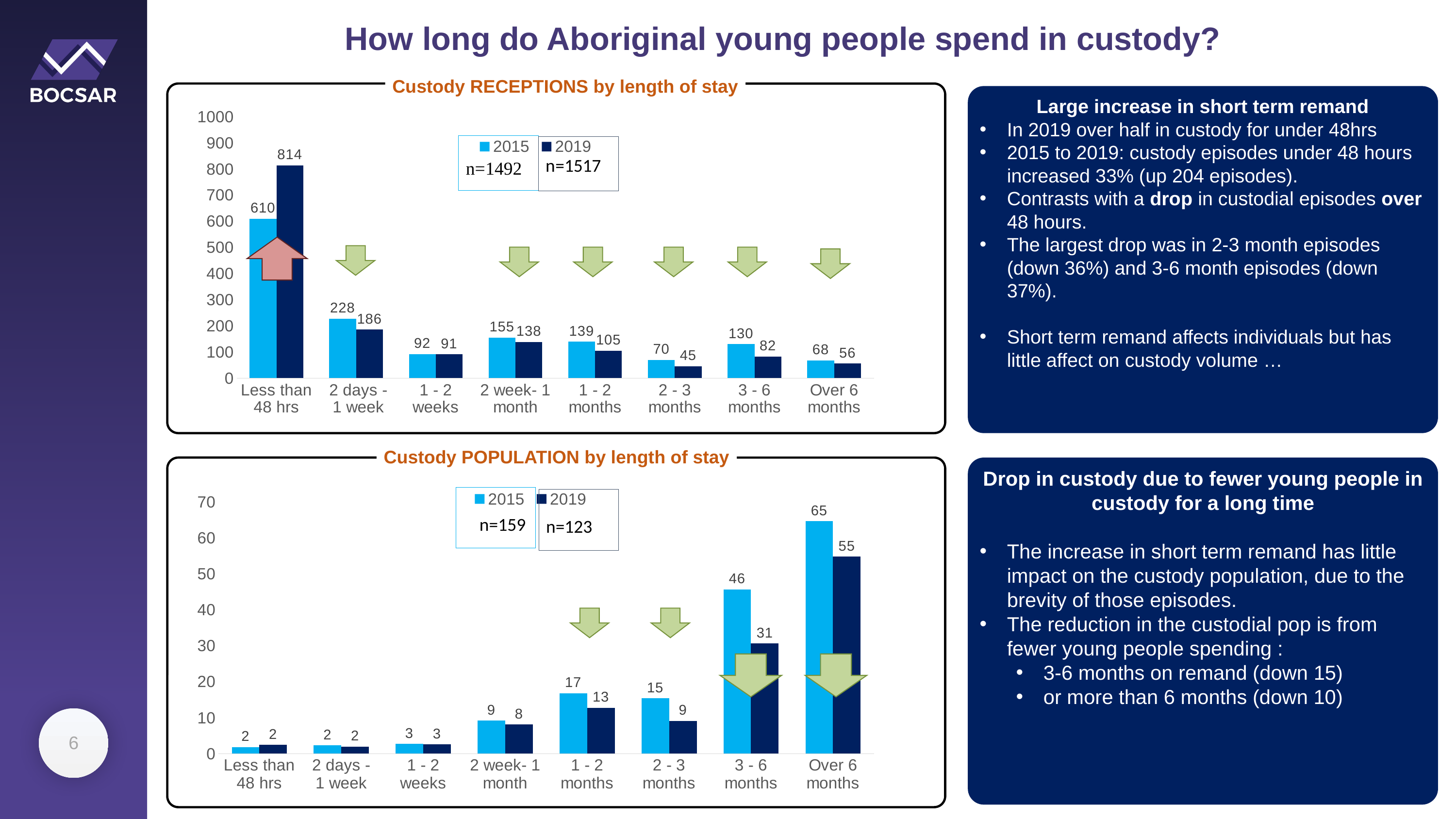
In the 'Custody RECEPTIONS by length of stay' chart, which length-of-stay category has the highest 2015 value? Less than 48 hrs How many length-of-stay categories are shown in the 'Custody RECEPTIONS by length of stay' chart? 8 What kind of chart is the 'Custody POPULATION by length of stay' chart? Bar chart In the 'Custody RECEPTIONS by length of stay' chart, which is larger for '3 - 6 months': the 2015 value or the 2019 value? 2015 In the 'Custody RECEPTIONS by length of stay' chart, what is the 2015 value for '2 days - 1 week'? 228 In the 'Custody POPULATION by length of stay' chart, what is the difference between the 2015 and 2019 values for '3 - 6 months'? 15 In the 'Custody POPULATION by length of stay' chart, what is the total n shown for 2015 in the legend? n=159 In the 'Custody RECEPTIONS by length of stay' chart, what is the 2019 value for 'Less than 48 hrs'? 814 How many series does the legend list in the 'Custody POPULATION by length of stay' chart? 2 In the 'Custody POPULATION by length of stay' chart, what is the 2019 value for 'Over 6 months'? 55 In the 'Custody RECEPTIONS by length of stay' chart, what is the difference between the 2019 and 2015 values for 'Less than 48 hrs'? 204 In the 'Custody RECEPTIONS by length of stay' chart, which length-of-stay category has the lowest 2019 value? 2 - 3 months